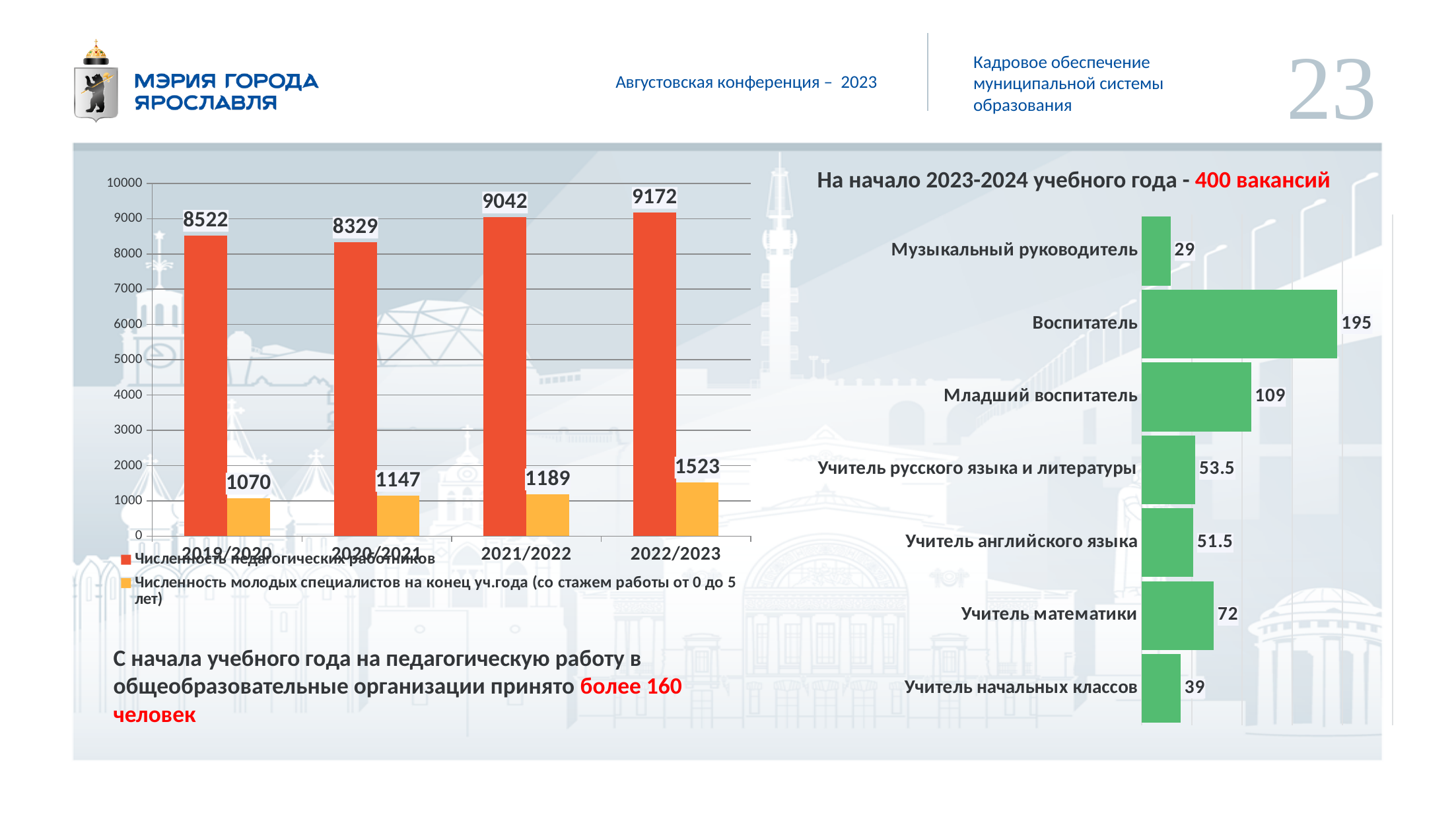
In the right chart (На начало 2023-2024 учебного года - 400 вакансий), which is larger: Учитель математики or Учитель начальных классов? Учитель математики In the left chart, what is the difference between Численность педагогических работников in 2022/2023 and in 2021/2022? 130 In the right chart (На начало 2023-2024 учебного года - 400 вакансий), which category has the lowest value? Музыкальный руководитель In the right chart (На начало 2023-2024 учебного года - 400 вакансий), how many categories are shown? 7 In the left chart, what colour are the bars for Численность педагогических работников? Red In the left chart, how many series does the legend list? 2 In the right chart (На начало 2023-2024 учебного года - 400 вакансий), what is the value for Воспитатель? 195 In the left chart, what is the value for Численность молодых специалистов in 2020/2021? 1147 In the left chart, what is the value for Численность педагогических работников in 2022/2023? 9172 In the left chart, which year has the lowest value for Численность педагогических работников? 2020/2021 In the left chart, does the value for Численность молодых специалистов rise or fall from 2019/2020 to 2022/2023? rise What kind of chart is the right chart (На начало 2023-2024 учебного года - 400 вакансий)? Bar chart